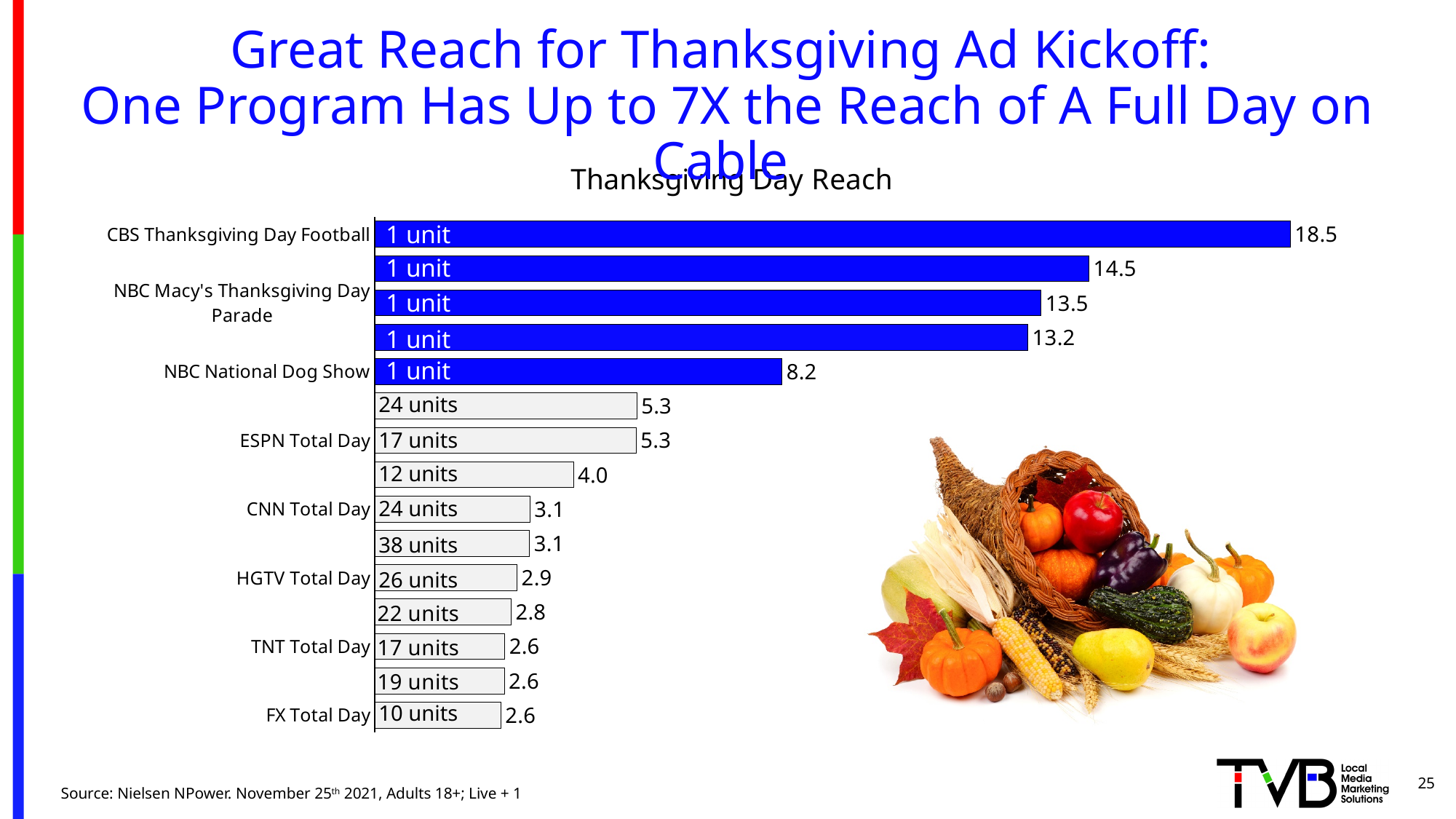
What is the reach value for CBS Thanksgiving Day Football? 18.5 How many bars are plotted in the chart? 15 Which has a larger reach value, NBC Macy's Thanksgiving Day Parade or ESPN Total Day? NBC Macy's Thanksgiving Day Parade What is the reach value for ESPN Total Day? 5.3 What kind of chart is shown on the slide? bar chart What is the reach value for NBC National Dog Show? 8.2 What is the reach value for NBC Macy's Thanksgiving Day Parade? 13.5 What is the reach value for HGTV Total Day? 2.9 Which category has the highest reach value? CBS Thanksgiving Day Football What is the difference between the reach of CBS Thanksgiving Day Football and NBC National Dog Show? 10.3 What is the title of the chart? Thanksgiving Day Reach What is the reach value for FX Total Day? 2.6